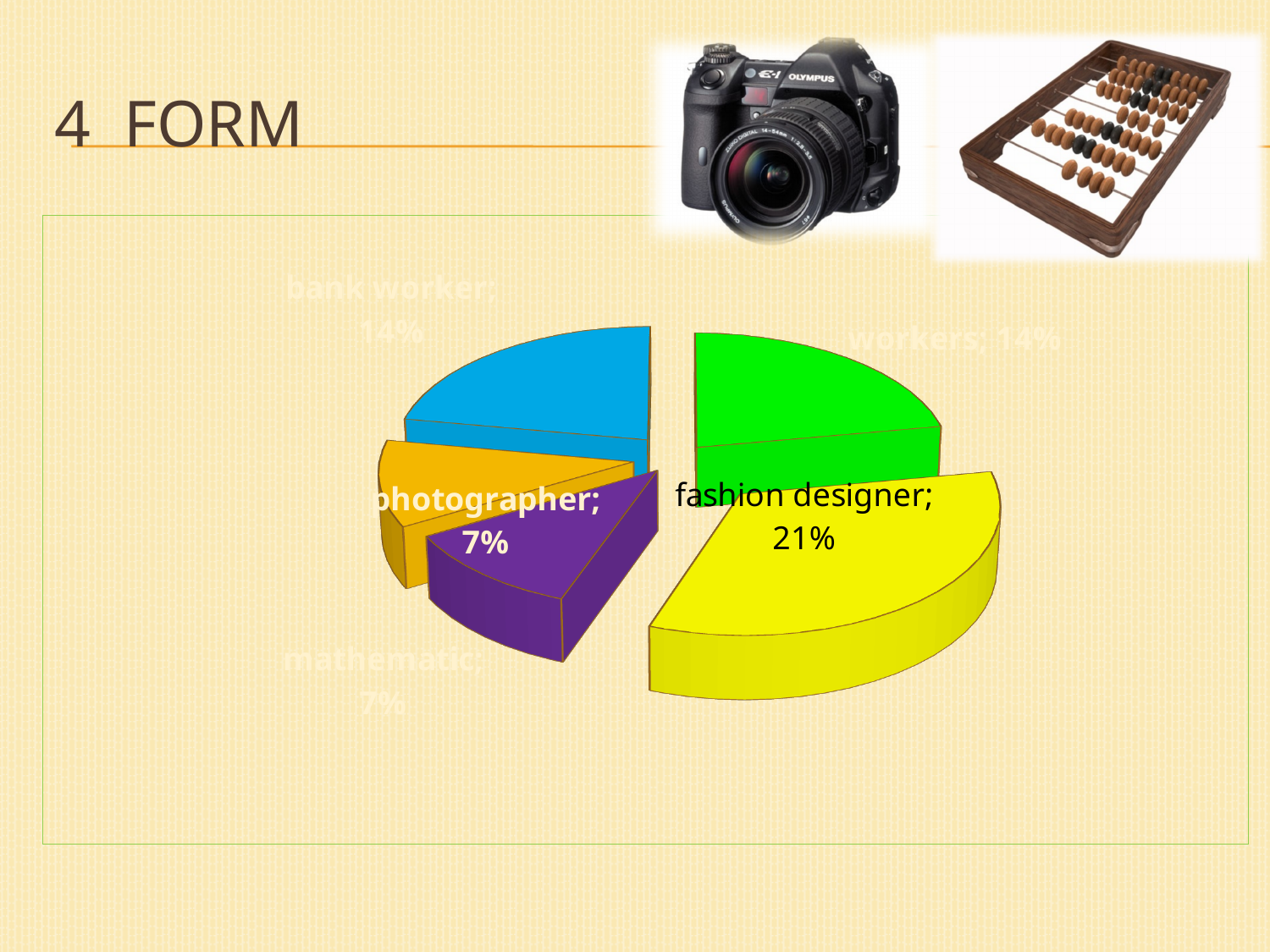
What is the difference in percentage points between fashion designer and bank worker? 7 What percentage is shown for photographer? 7% Which is larger, the share for fashion designer or the share for bank worker? fashion designer What colour is the fashion designer slice? yellow How many labelled categories does the pie chart show? 5 Which category has the largest share of the pie? fashion designer What percentage is shown for bank worker? 14% What percentage is shown for fashion designer? 21% What kind of chart is shown on the slide? pie chart What percentage is shown for workers? 14% Which is larger, the share for workers or the share for photographer? workers What percentage is shown for mathematic? 7%